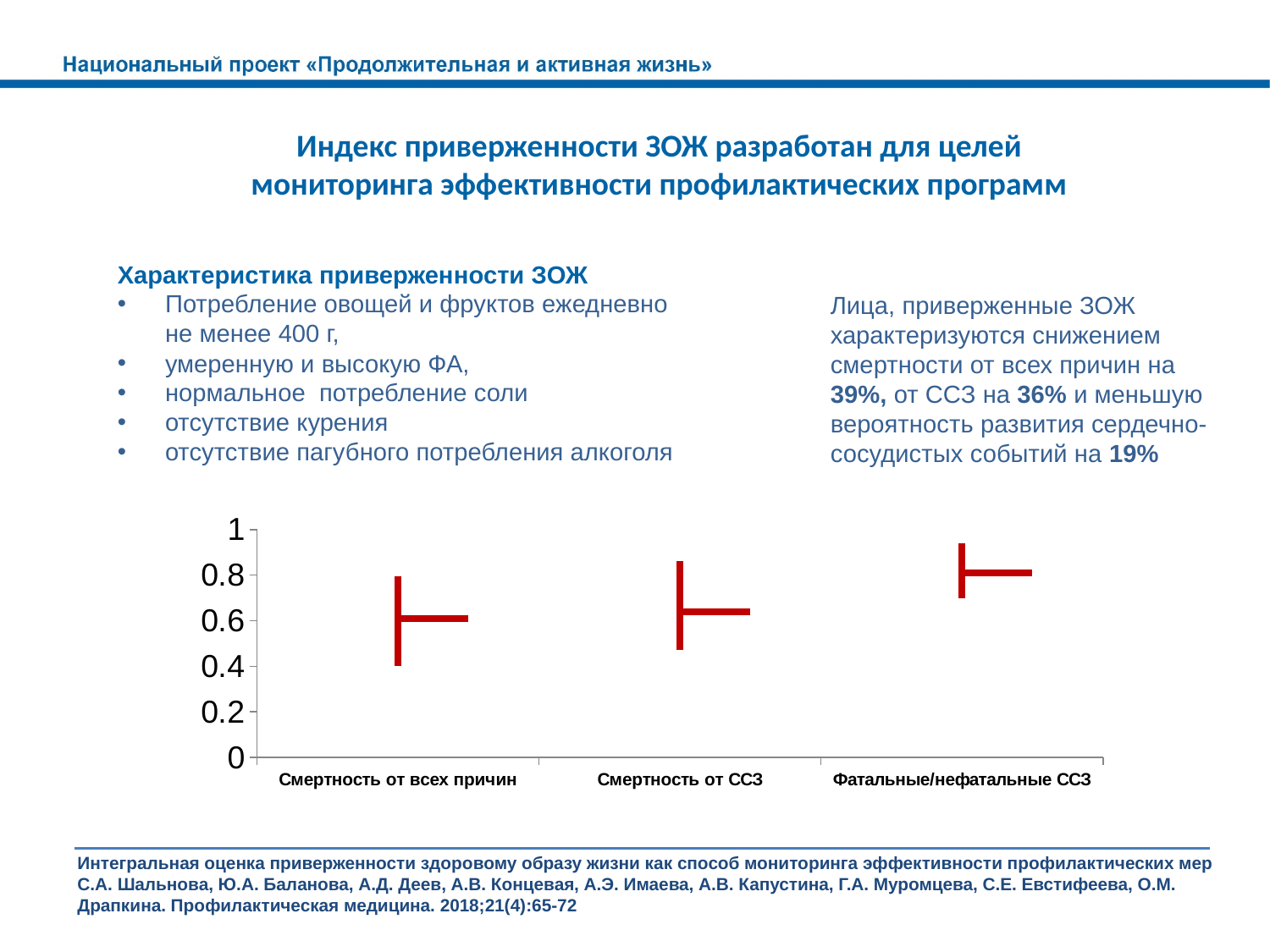
Do the plotted values rise or fall from left to right along the x axis? rise What is the highest tick value shown on the y axis of the chart? 1 How many categories are shown on the x axis of the chart? 3 Is the plotted value for Смертность от всех причин greater or less than 0.8? less What colour are the markers and error bars in the chart? red Which category has the highest plotted value in the chart? Фатальные/нефатальные ССЗ Is the plotted value for Смертность от ССЗ greater or less than 0.8? less Is the plotted value for Фатальные/нефатальные ССЗ greater or less than 0.6? greater Which is larger: the plotted value for Фатальные/нефатальные ССЗ or for Смертность от всех причин? Фатальные/нефатальные ССЗ What is the label of the middle category on the x axis? Смертность от ССЗ